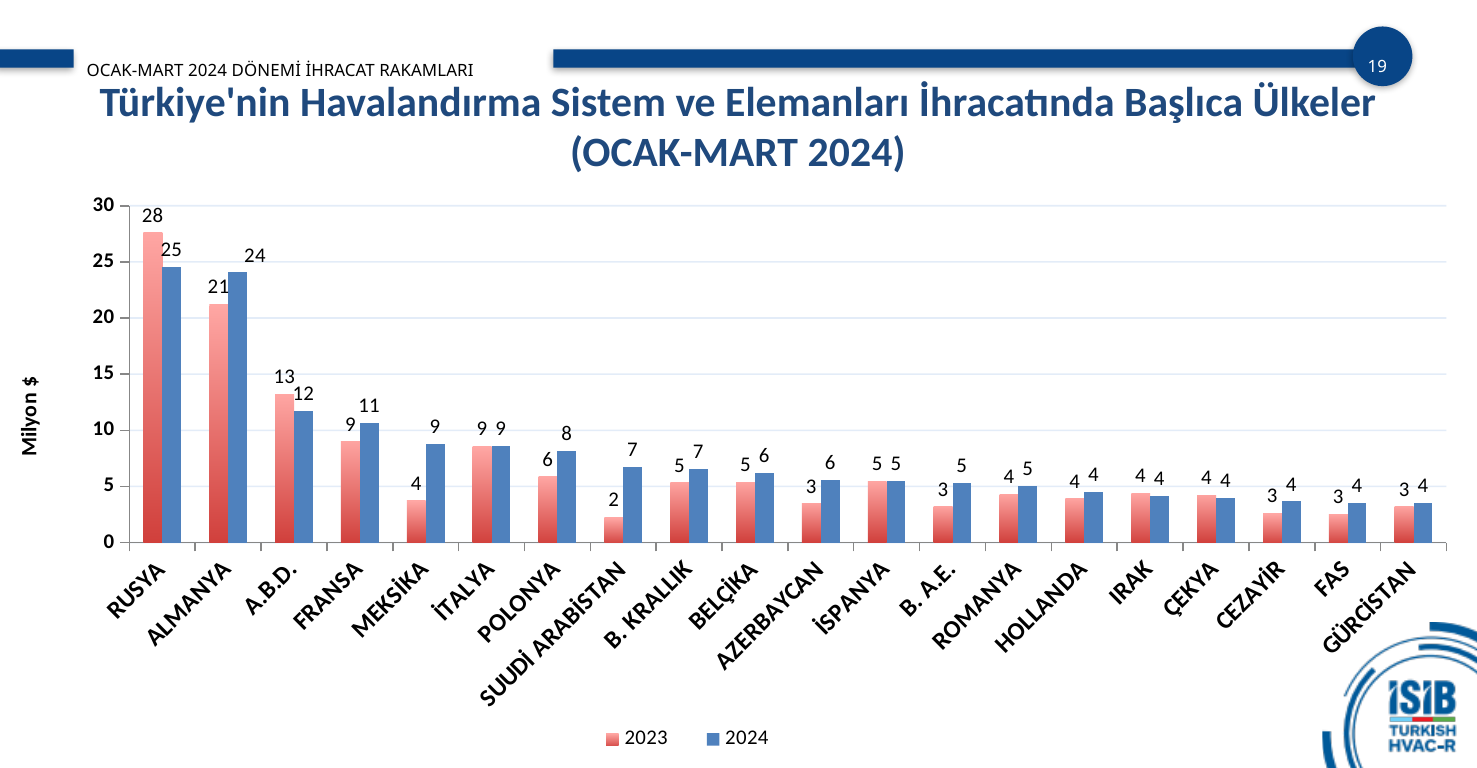
Which is larger for FRANSA, the 2023 value or the 2024 value? 2024 What is the 2024 value for SUUDİ ARABİSTAN? 7 What is the difference between the 2024 values for ALMANYA and A.B.D.? 12 Which country has the highest 2023 value? RUSYA What is the 2023 value for MEKSİKA? 4 Which country has the lowest 2023 value? SUUDİ ARABİSTAN What kind of chart is shown on the slide? Bar chart What is the label of the y axis? Milyon $ What is the difference between the 2023 and 2024 values for RUSYA? 3 How many series does the legend list? 2 What is the 2024 value for ALMANYA? 24 How many countries are shown on the x axis? 20